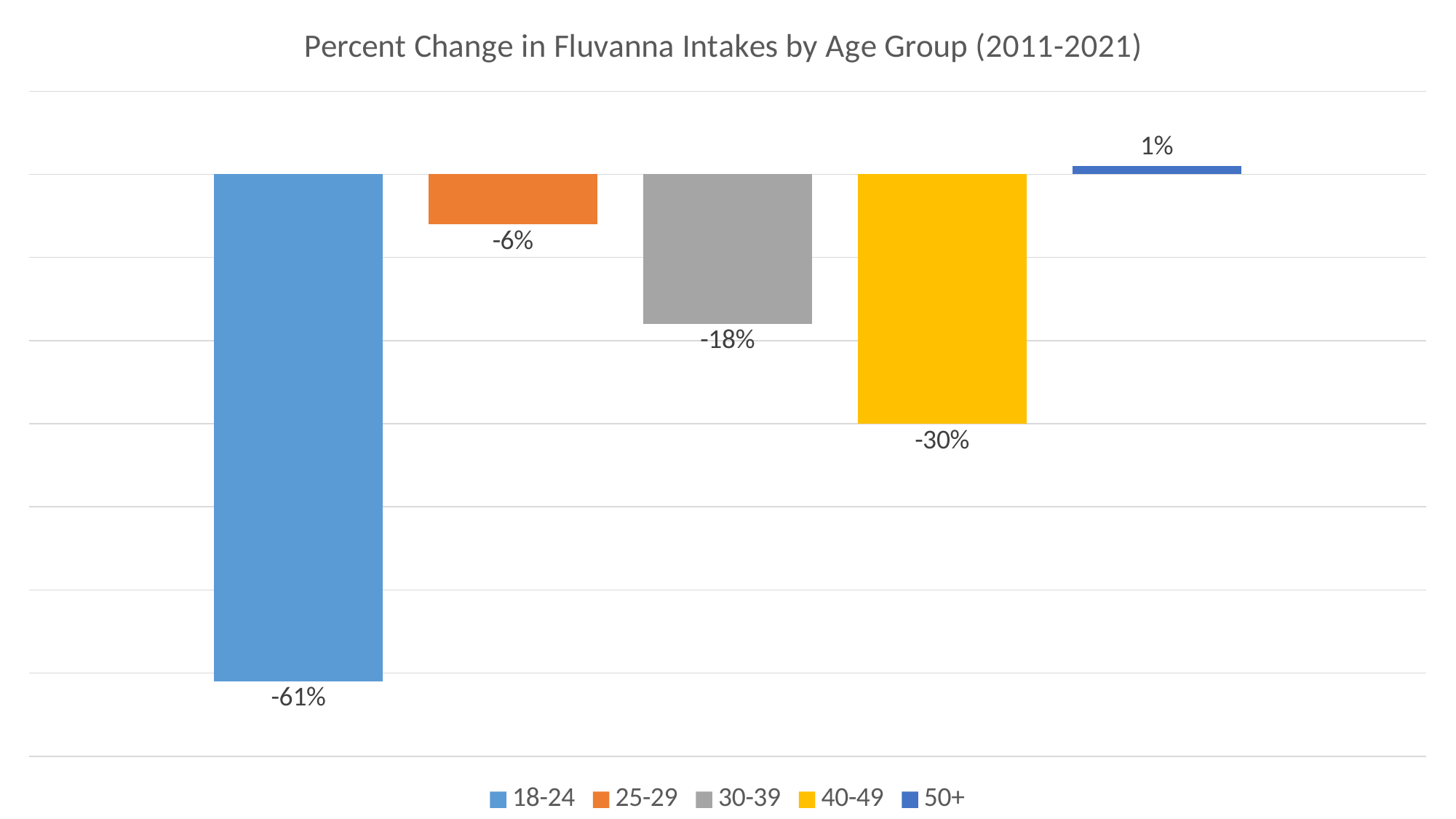
What is the percent change in Fluvanna intakes for the 50+ age group? 1% What is the percent change in Fluvanna intakes for the 25-29 age group? -6% What is the percent change in Fluvanna intakes for the 40-49 age group? -30% Which age group has the lowest percent change in Fluvanna intakes? 18-24 How many age groups are shown in the chart? 5 By how many percentage points does the percent change for the 30-39 age group differ from that of the 25-29 age group? 12 percentage points What is the percent change in Fluvanna intakes for the 18-24 age group? -61% What type of chart is shown on the slide? Bar chart Which age group has the highest percent change in Fluvanna intakes? 50+ What is the title of the chart? Percent Change in Fluvanna Intakes by Age Group (2011-2021) What is the percent change in Fluvanna intakes for the 30-39 age group? -18%